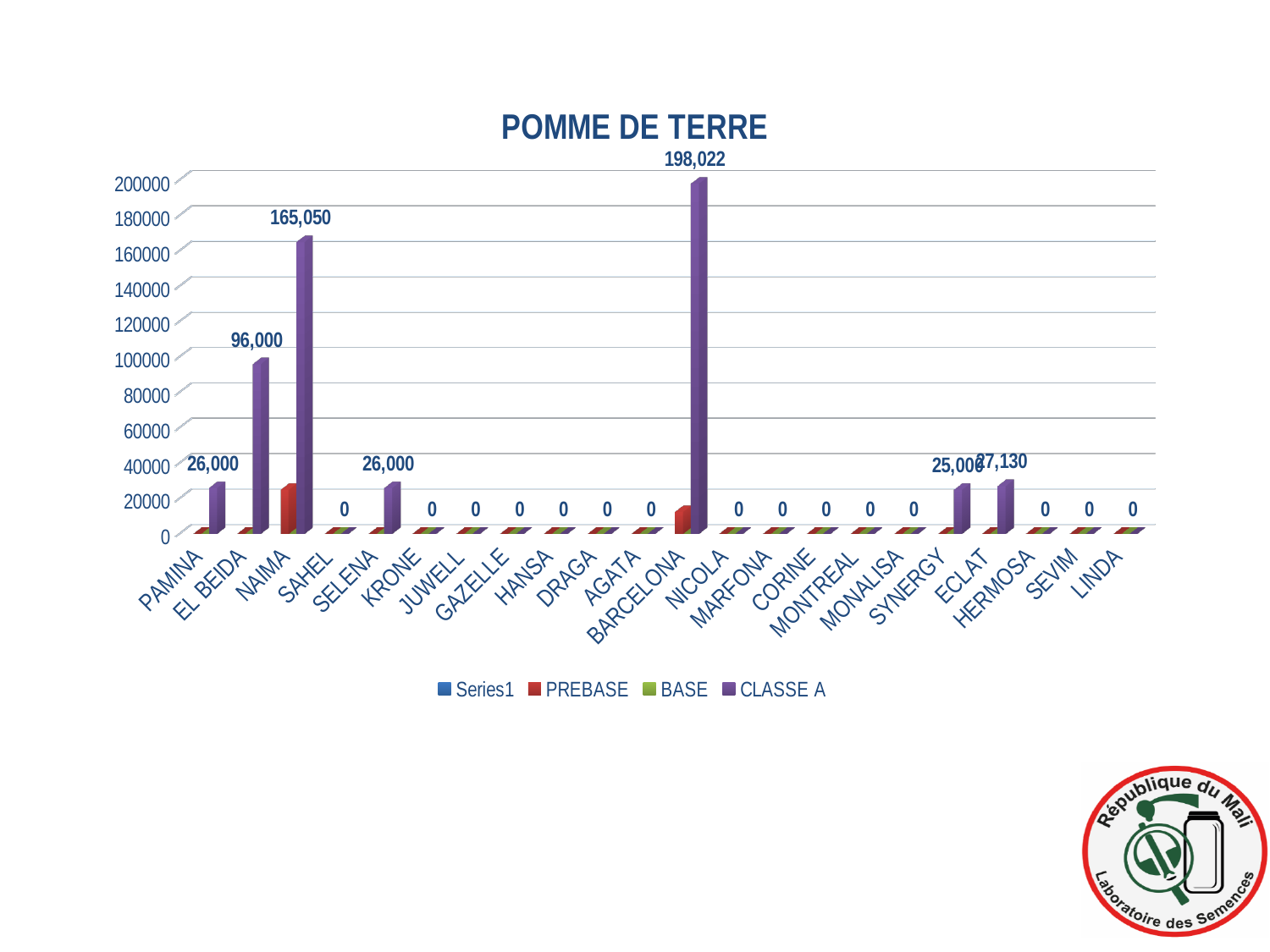
What is the title of the chart? POMME DE TERRE What is the CLASSE A value for ECLAT? 27,130 What kind of chart is shown on the slide? bar chart Which has the larger CLASSE A value, EL BEIDA or NAIMA? NAIMA Which variety has the highest CLASSE A value? BARCELONA What is the CLASSE A value for EL BEIDA? 96,000 What is the CLASSE A value for NAIMA? 165,050 What is the difference between the CLASSE A values for BARCELONA and NAIMA? 32,972 Is the CLASSE A value for SYNERGY greater or less than 40000? less What is the CLASSE A value for BARCELONA? 198,022 How many varieties are shown on the x axis? 22 How many series does the legend list? 4